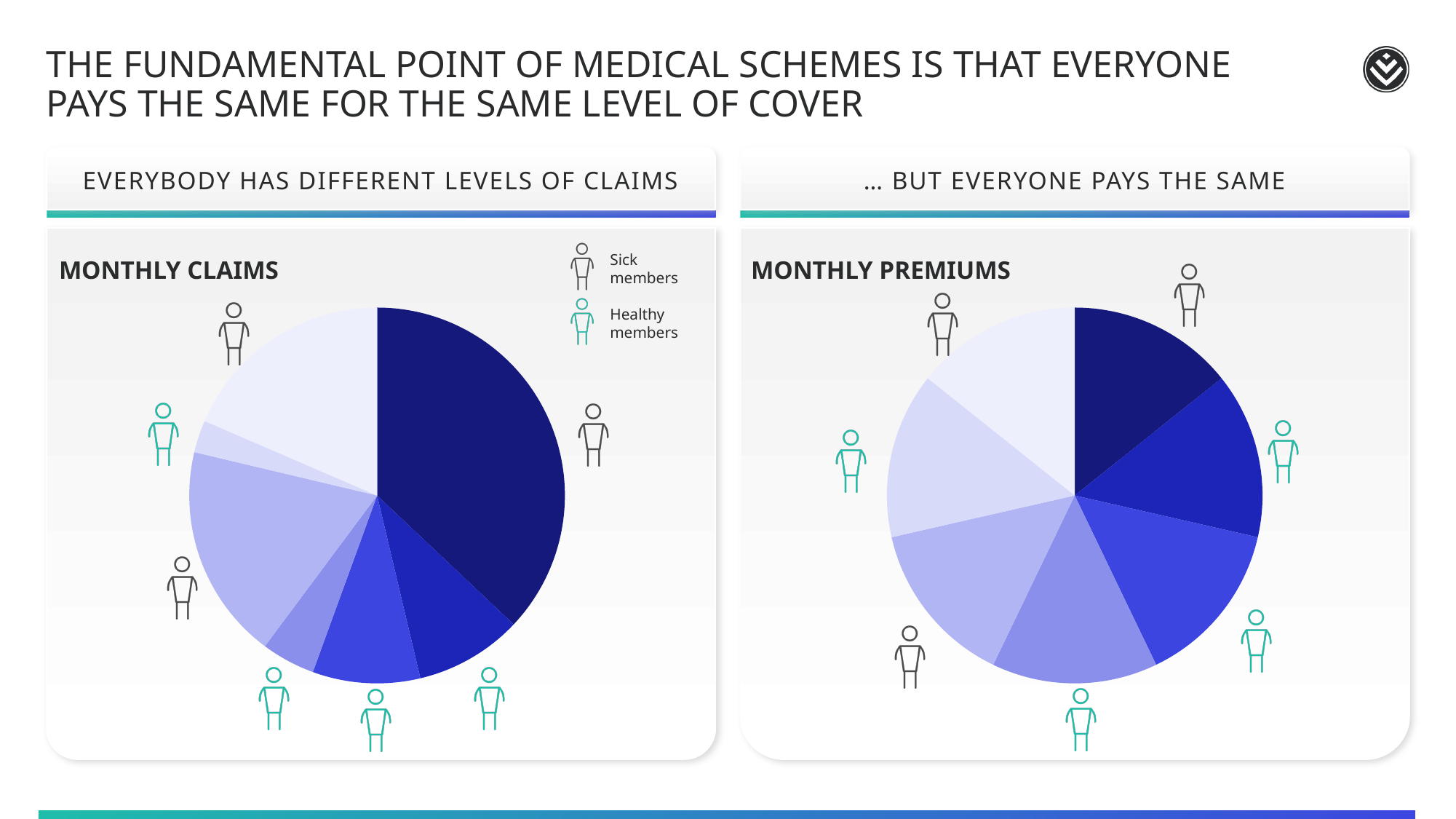
How many pie charts are shown on the slide? 2 What kind of chart is the Monthly Claims chart? pie chart In the Monthly Claims pie chart, which colour slice is the largest? the dark navy slice How many slices does the Monthly Premiums pie chart have? 7 How many member types does the legend on the Monthly Claims chart list? 2 What are the two member types listed in the legend of the Monthly Claims chart? Sick members and Healthy members What kind of chart is the Monthly Premiums chart? pie chart In the Monthly Claims pie chart, is the largest slice greater or less than 25% of the pie? greater What is the title of the pie chart on the left side of the slide? MONTHLY CLAIMS How many slices does the Monthly Claims pie chart have? 7